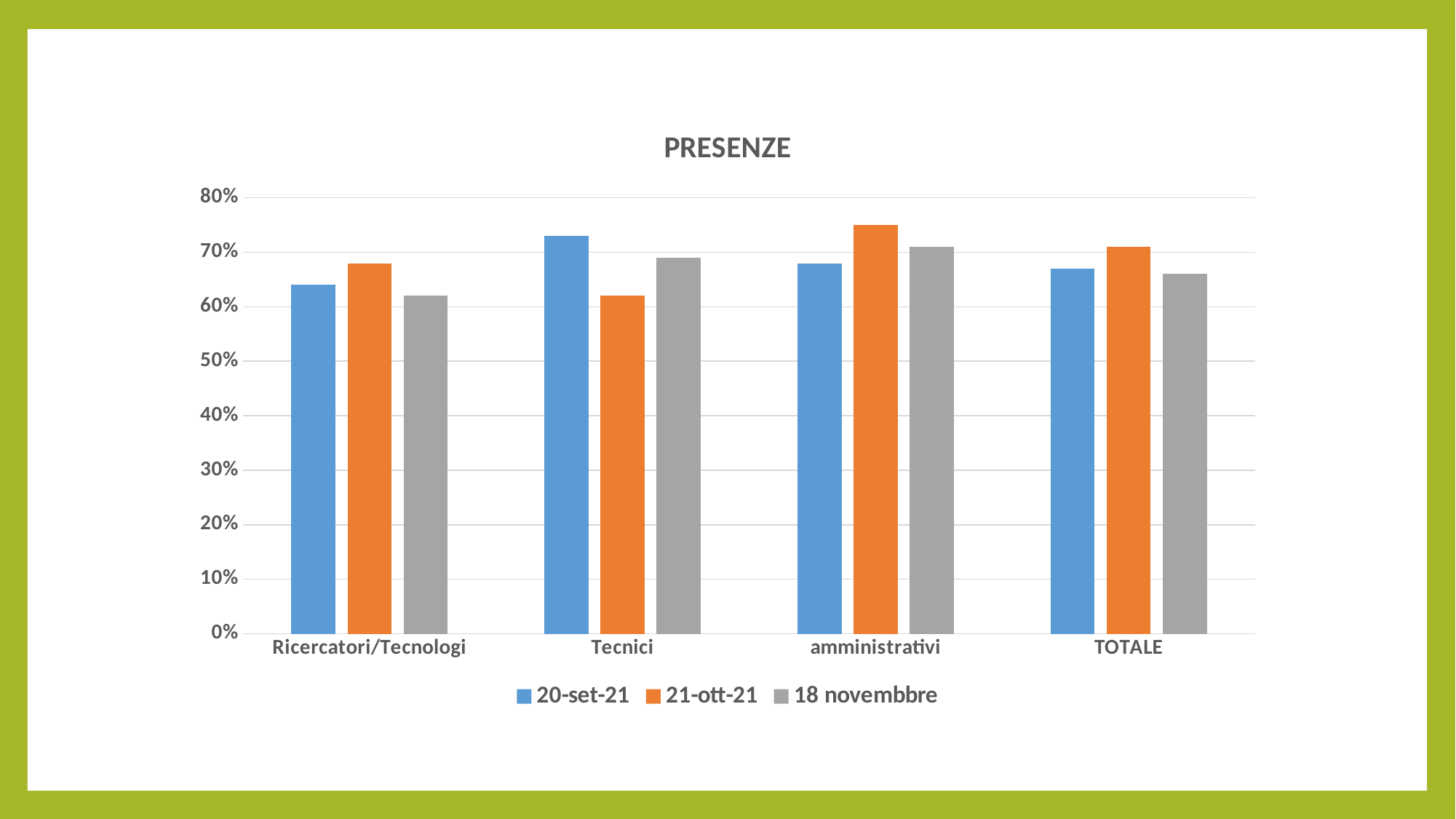
Is the value for Ricercatori/Tecnologi in the 18 novembbre series greater or less than 60%? greater Which series is shown in orange? 21-ott-21 Is the value for Tecnici in the 21-ott-21 series greater or less than 70%? less Which category has the highest value in the 21-ott-21 series? amministrativi For Tecnici, which is larger: the 20-set-21 value or the 21-ott-21 value? 20-set-21 How many series does the legend list? 3 What kind of chart is shown on the slide? bar chart Which category has the highest value in the 20-set-21 series? Tecnici Is the value for amministrativi in the 21-ott-21 series greater or less than 70%? greater What is the title of the chart? PRESENZE How many categories are shown on the x axis? 4